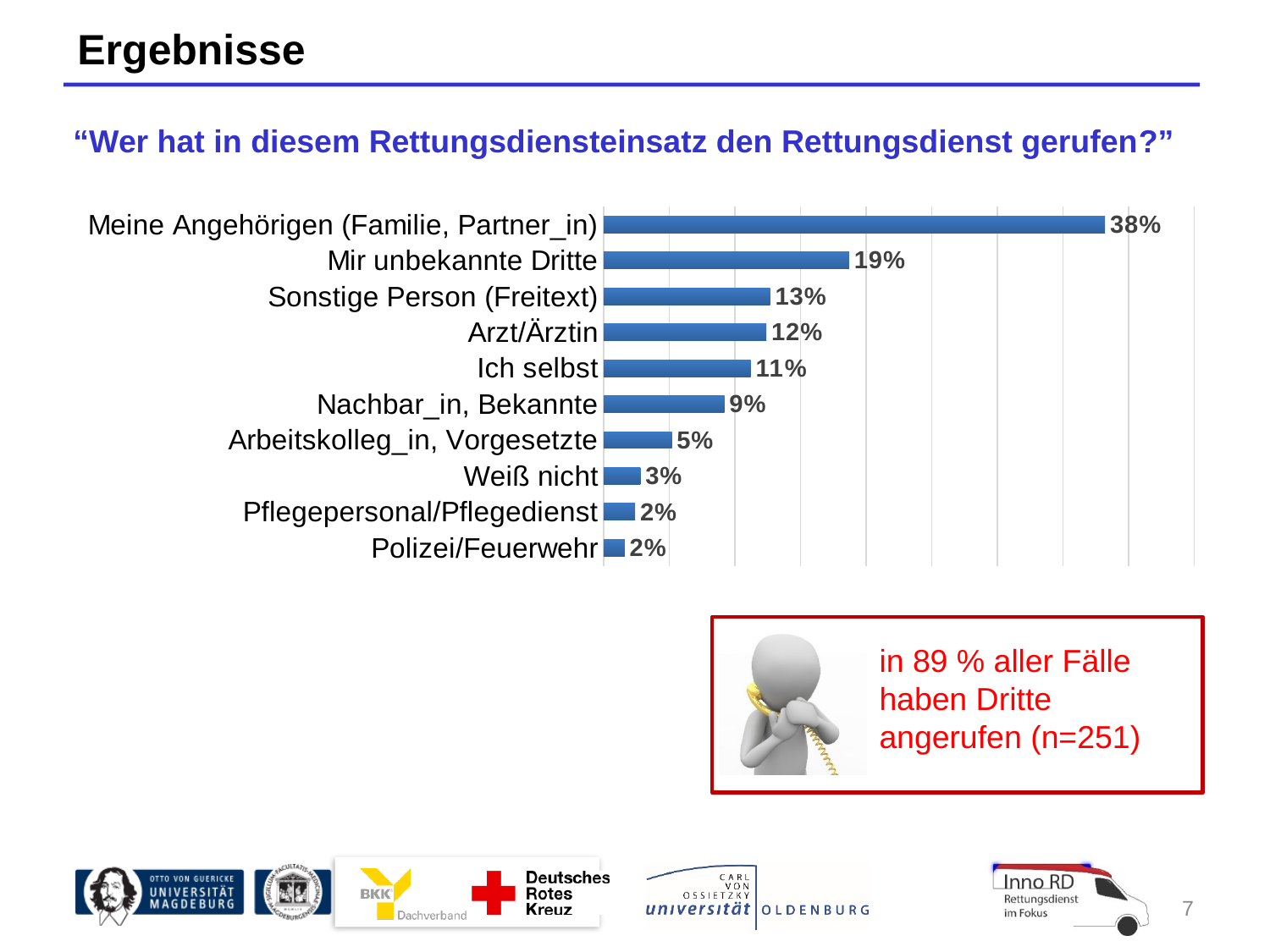
What percentage is shown for "Arzt/Ärztin"? 12% Which category has the highest value? Meine Angehörigen (Familie, Partner_in) What is the difference between "Meine Angehörigen (Familie, Partner_in)" and "Mir unbekannte Dritte"? 19% What percentage is shown for "Ich selbst"? 11% How many categories are shown in the chart? 10 What kind of chart is shown on the slide? Bar chart What percentage is shown for "Weiß nicht"? 3% What is the difference between "Sonstige Person (Freitext)" and "Ich selbst"? 2% Which is larger, "Nachbar_in, Bekannte" or "Arbeitskolleg_in, Vorgesetzte"? Nachbar_in, Bekannte What percentage is shown for "Meine Angehörigen (Familie, Partner_in)"? 38% Which is larger, "Mir unbekannte Dritte" or "Sonstige Person (Freitext)"? Mir unbekannte Dritte What question is the chart answering, according to the heading above it? "Wer hat in diesem Rettungsdiensteinsatz den Rettungsdienst gerufen?"